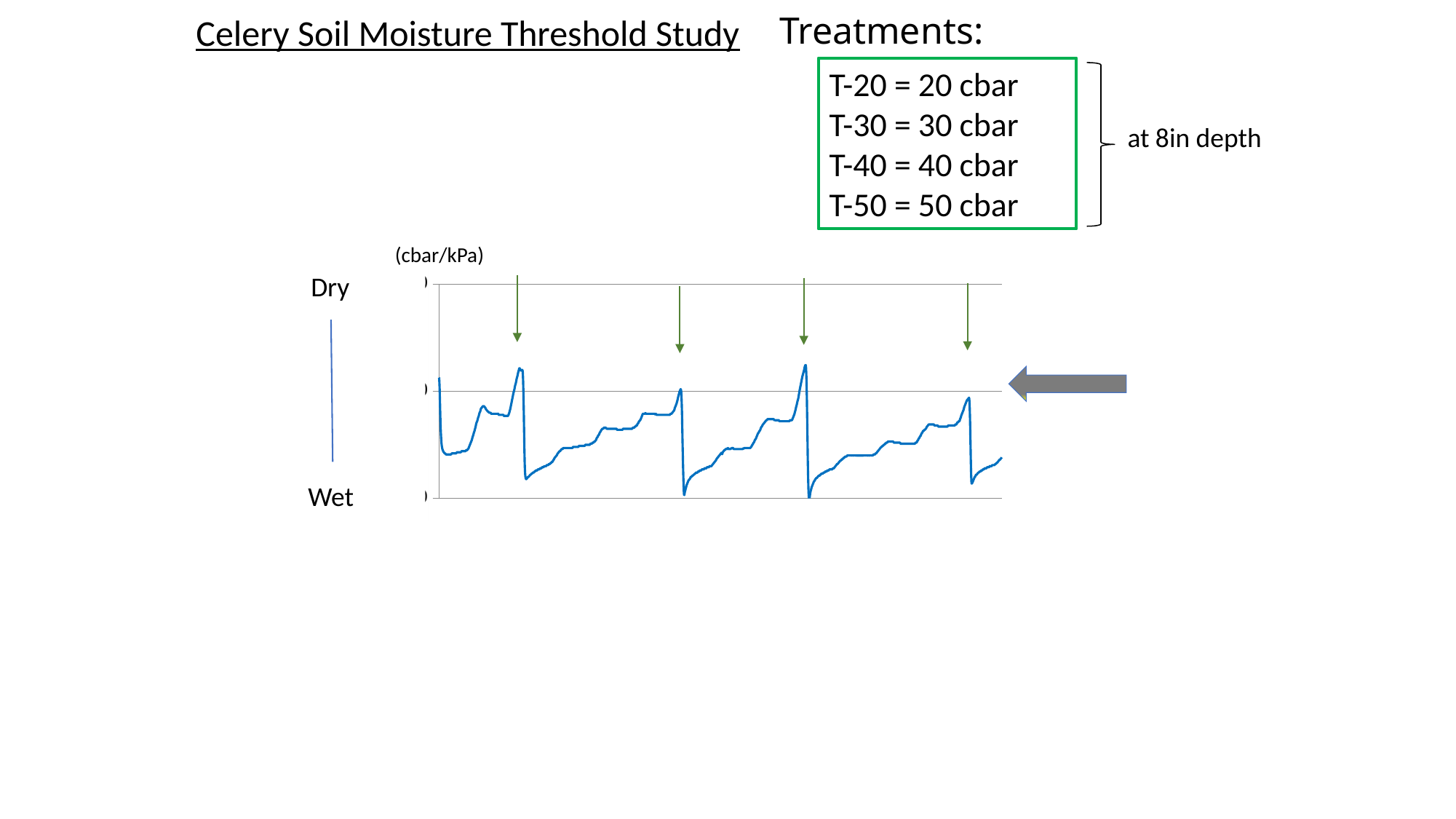
What kind of chart is shown on the slide? line chart What colour is the plotted line on the chart? blue What unit label is printed above the chart's vertical axis? (cbar/kPa) How many data series are plotted on the chart? 1 How many green downward arrows are placed above the plotted line? 4 How many sharp drops does the plotted line show across the chart? 4 Between two sharp drops, does the plotted line generally rise or fall along the x axis? rise Which label is placed at the top of the chart's vertical axis, Dry or Wet? Dry